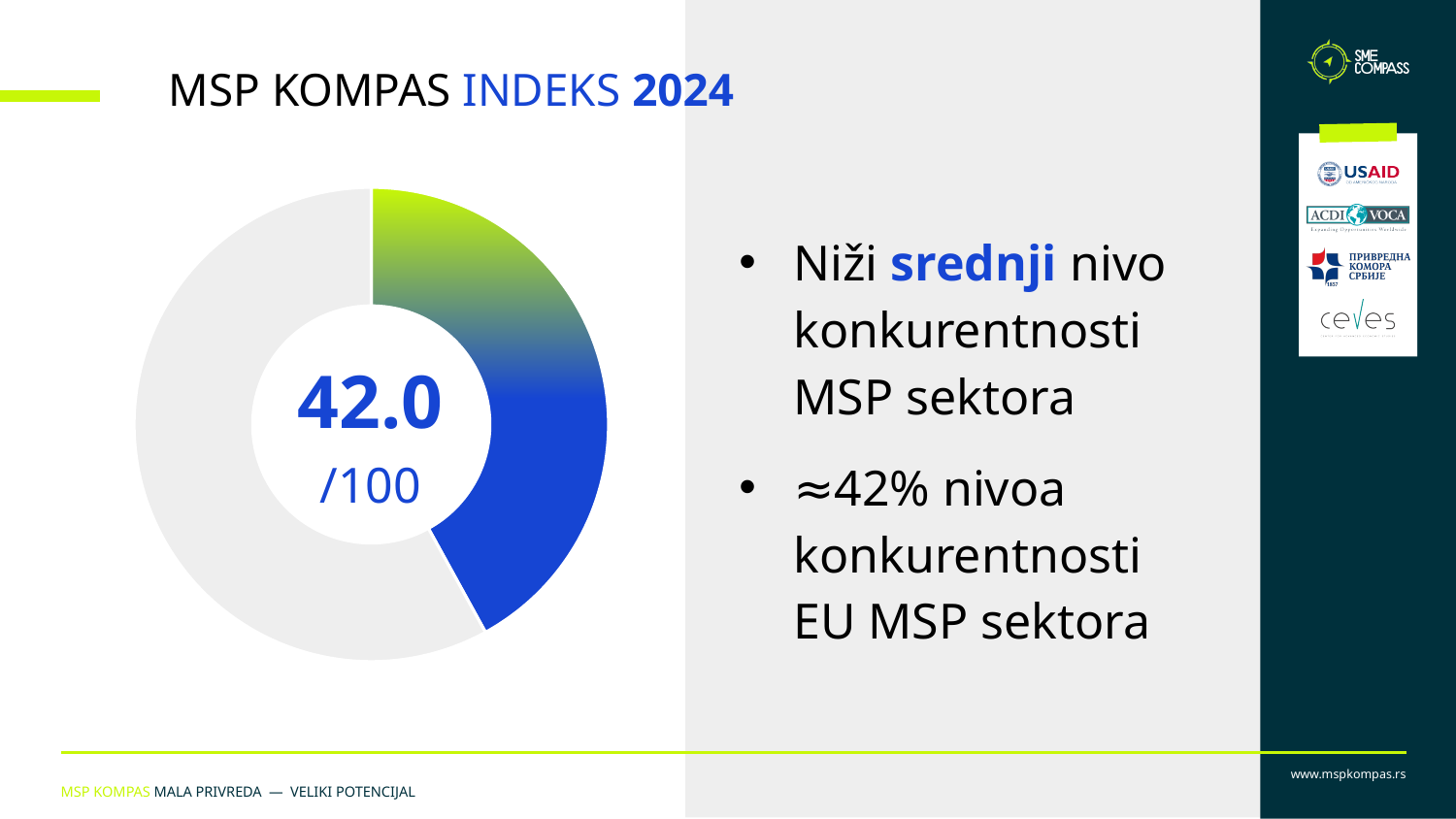
How many points short of 100 is the index value shown in the donut chart? 58.0 Is the index value shown in the donut chart greater or less than 50? less What kind of chart is shown on the slide? Donut (pie) chart What is the title of the slide containing the donut chart? MSP KOMPAS INDEKS 2024 What value is displayed in the centre of the donut chart? 42.0 Out of what maximum is the index value of 42.0 expressed? 100 What share of the full ring does the coloured (filled) segment of the donut represent? 42% How many segments does the donut chart have? 2 What colours are used for the filled segment of the donut chart? A green-to-blue gradient Which segment of the donut is larger, the coloured (filled) segment or the grey (unfilled) segment? The grey (unfilled) segment